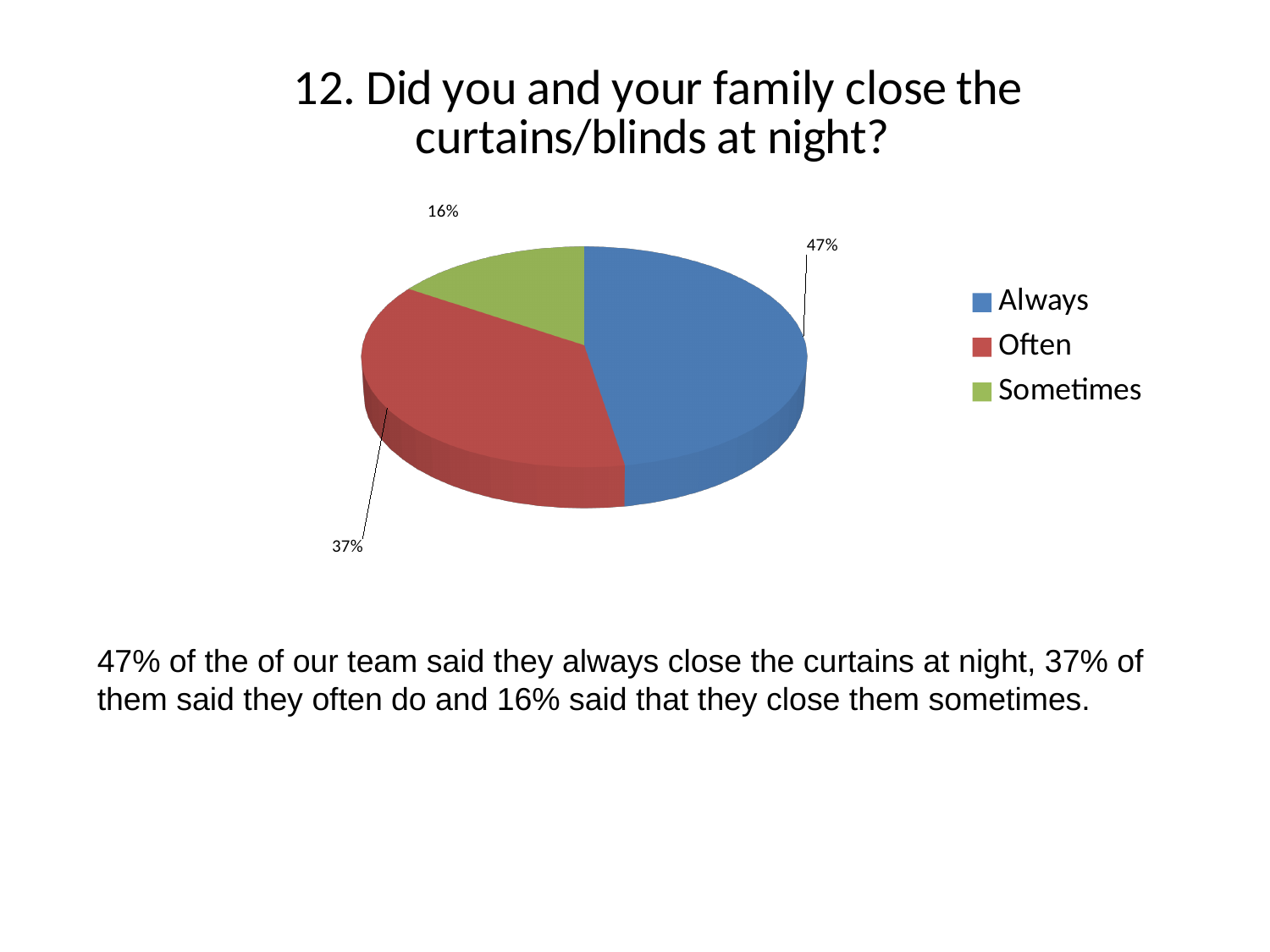
What colour is the Often slice in the pie chart? Red What percentage of the pie is labelled for the Always slice? 47% What percentage of the pie is labelled for the Often slice? 37% What kind of chart is shown on the slide? Pie chart Which category has the largest slice of the pie? Always What is the title of the chart on the slide? 12. Did you and your family close the curtains/blinds at night? What percentage of the pie is labelled for the Sometimes slice? 16% Which slice is larger, Often or Sometimes? Often What is the difference in percentage points between the Always and Often slices? 10 How many categories does the pie chart show? 3 Which category has the smallest slice of the pie? Sometimes What is the difference in percentage points between the Often and Sometimes slices? 21